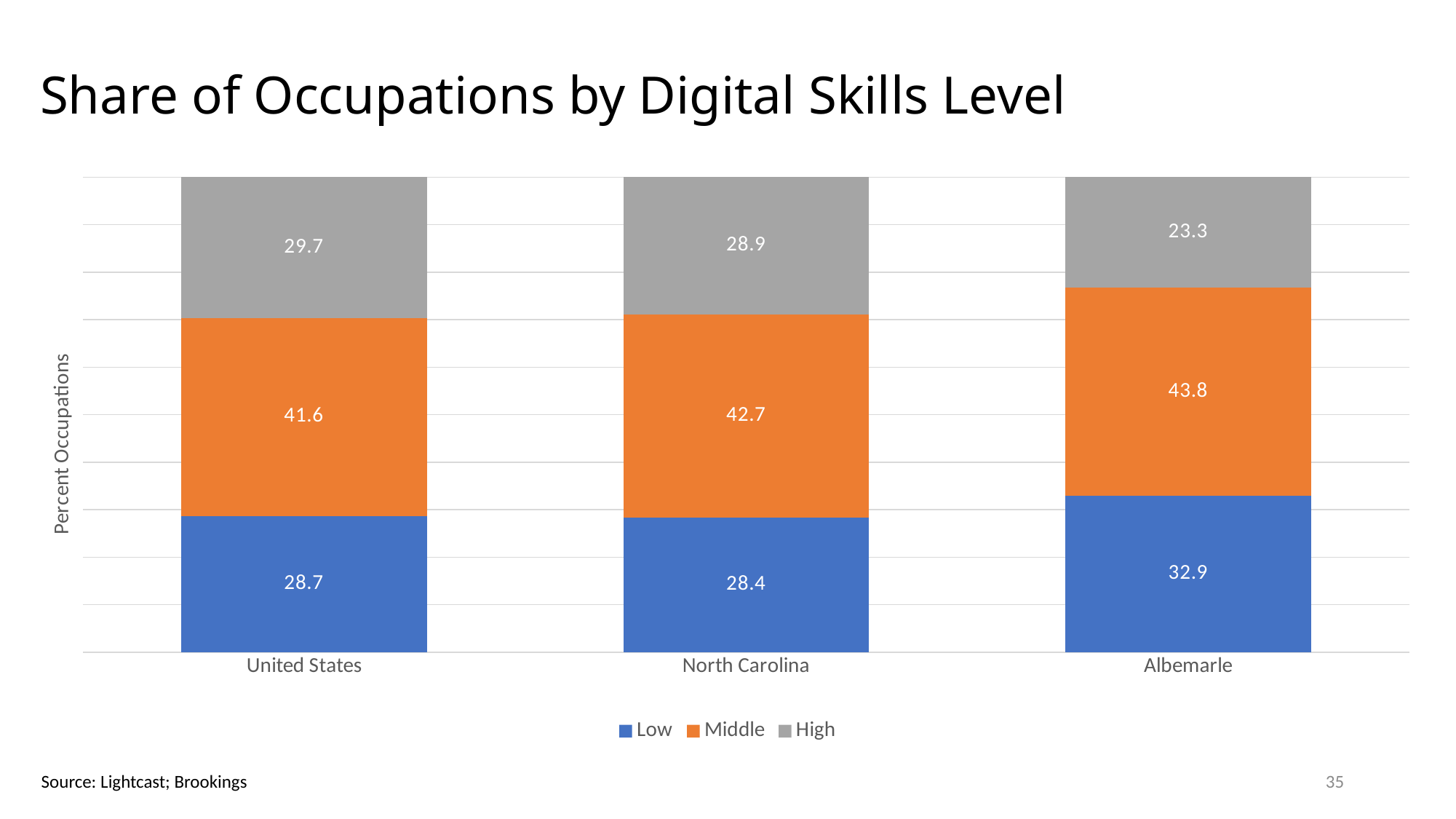
How many series does the legend list? 3 How many categories are shown on the x axis? 3 What is the difference between the Low value for Albemarle and the Low value for North Carolina? 4.5 Which category has the highest Middle value? Albemarle Which category has the lowest High value? Albemarle What is the total of the stacked bar for North Carolina? 100.0 What is the Middle value for North Carolina? 42.7 What is the High value for the United States? 29.7 Which category has the highest High value? United States What kind of chart is shown on the slide? Stacked bar chart Is the Middle value larger for the United States or for Albemarle? Albemarle What is the Low value for Albemarle? 32.9